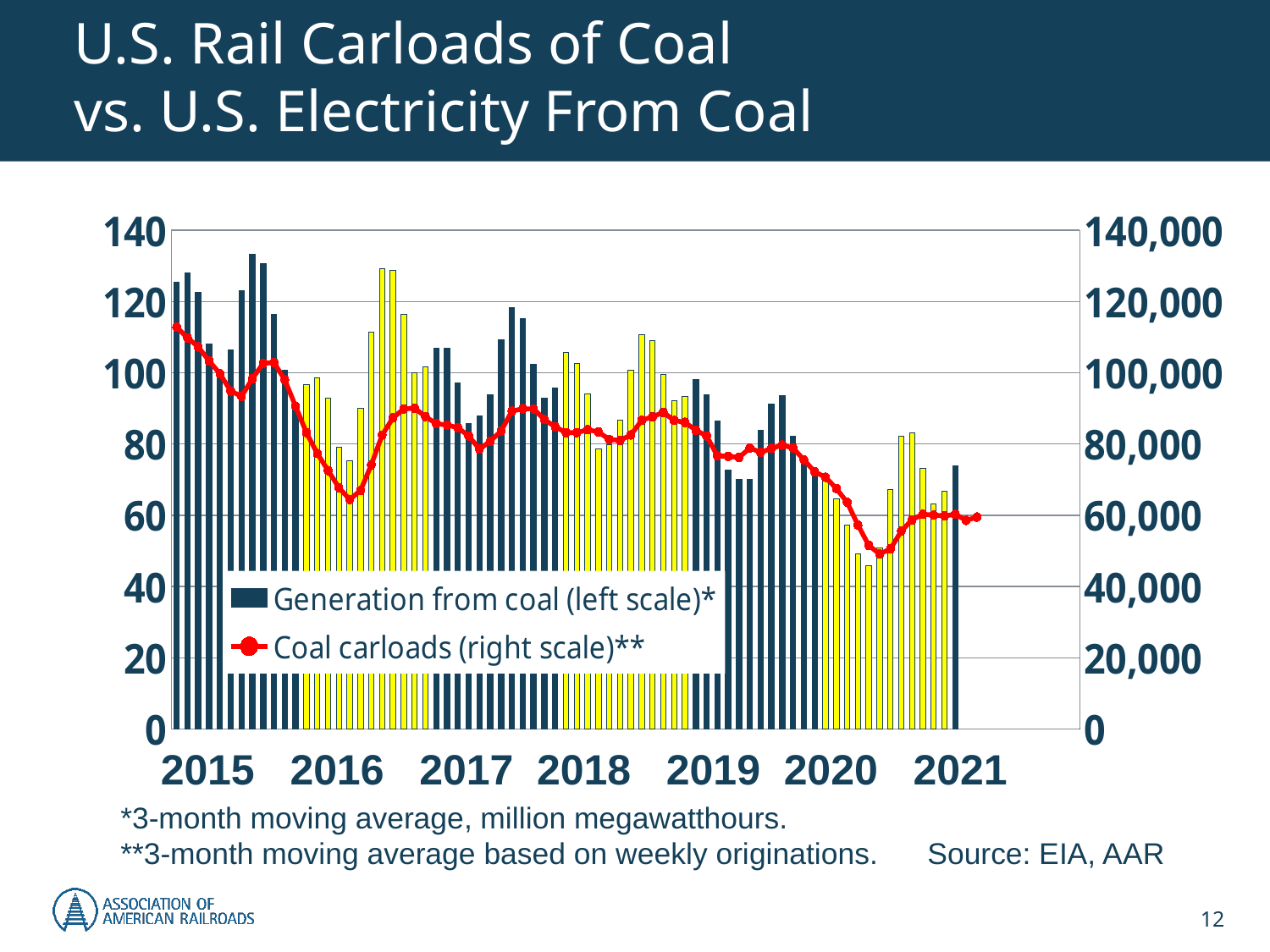
Overall, do the generation from coal bars rise or fall from 2015 to 2021? Fall Is the coal carloads value at the start of 2015 greater or less than 100,000? greater Overall, does the coal carloads line rise or fall from 2015 to 2021? Fall Which series is plotted on the left scale? Generation from coal (left scale)* What kind of chart is shown on the slide? A combination bar and line chart Is the lowest generation from coal bar in 2020 greater or less than 60? less Is the coal carloads value at the end of the series in 2021 greater or less than 80,000? less How many series does the legend list? 2 Which series is plotted on the right scale? Coal carloads (right scale)** In which year does the coal carloads line reach its highest point? 2015 How many years are labeled on the x axis? 7